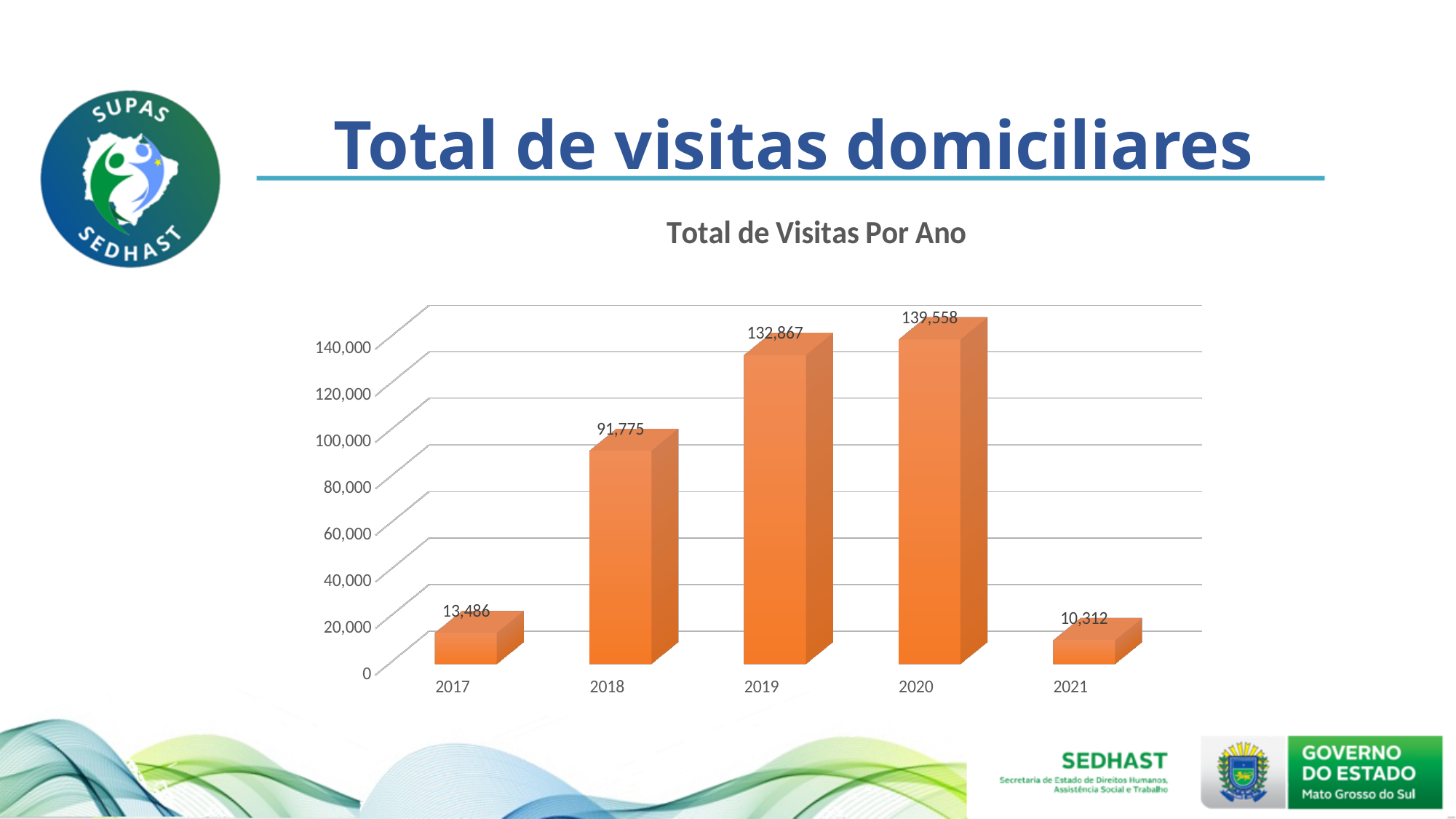
What is the value for 2017? 13,486 What is the difference between the values for 2020 and 2019? 6,691 Which year has the highest value? 2020 Which year has the lowest value? 2021 What is the value for 2021? 10,312 Which is larger, the value for 2018 or the value for 2019? 2019 How many years are shown on the x axis? 5 What kind of chart is this? bar chart What is the value for 2018? 91,775 Is the value for 2018 greater or less than 80,000? greater What is the value for 2019? 132,867 What is the title of the chart? Total de Visitas Por Ano